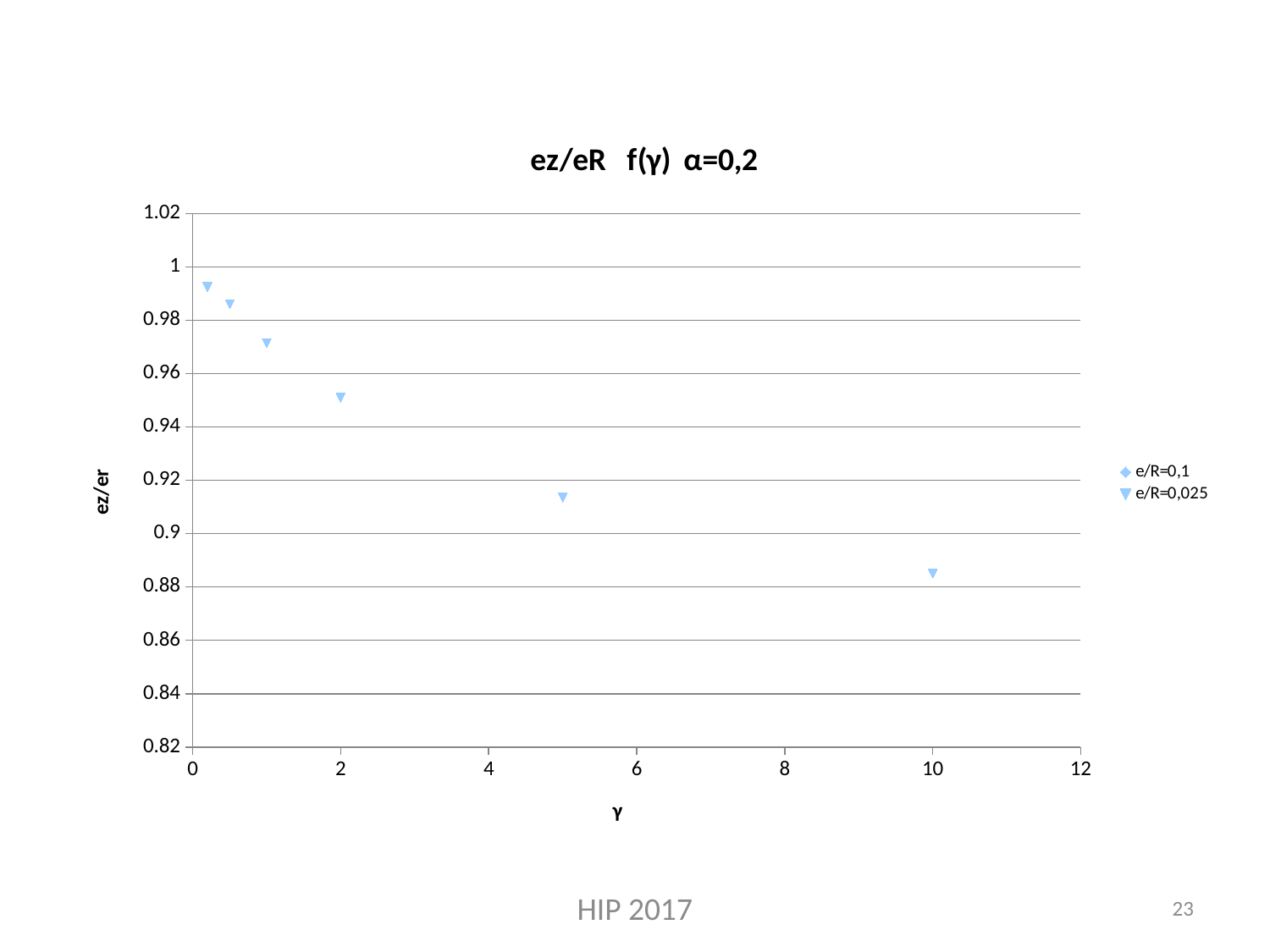
How many series does the legend list? 2 Do the plotted ez/er values rise or fall as γ increases? fall Is the ez/er value at γ = 5 greater or less than 0.9? greater Is the ez/er value at γ = 2 greater or less than 0.94? greater Which is larger, the ez/er value at γ = 2 or at γ = 5? γ = 2 What kind of chart is shown on the slide? scatter chart Is the ez/er value at γ = 10 greater or less than 0.9? less Which plotted point has the lowest ez/er value, the one at γ = 2 or the one at γ = 10? γ = 10 What is the title of the chart? ez/eR f(γ) α=0,2 What is the label of the x axis? γ How many data points are plotted on the chart? 6